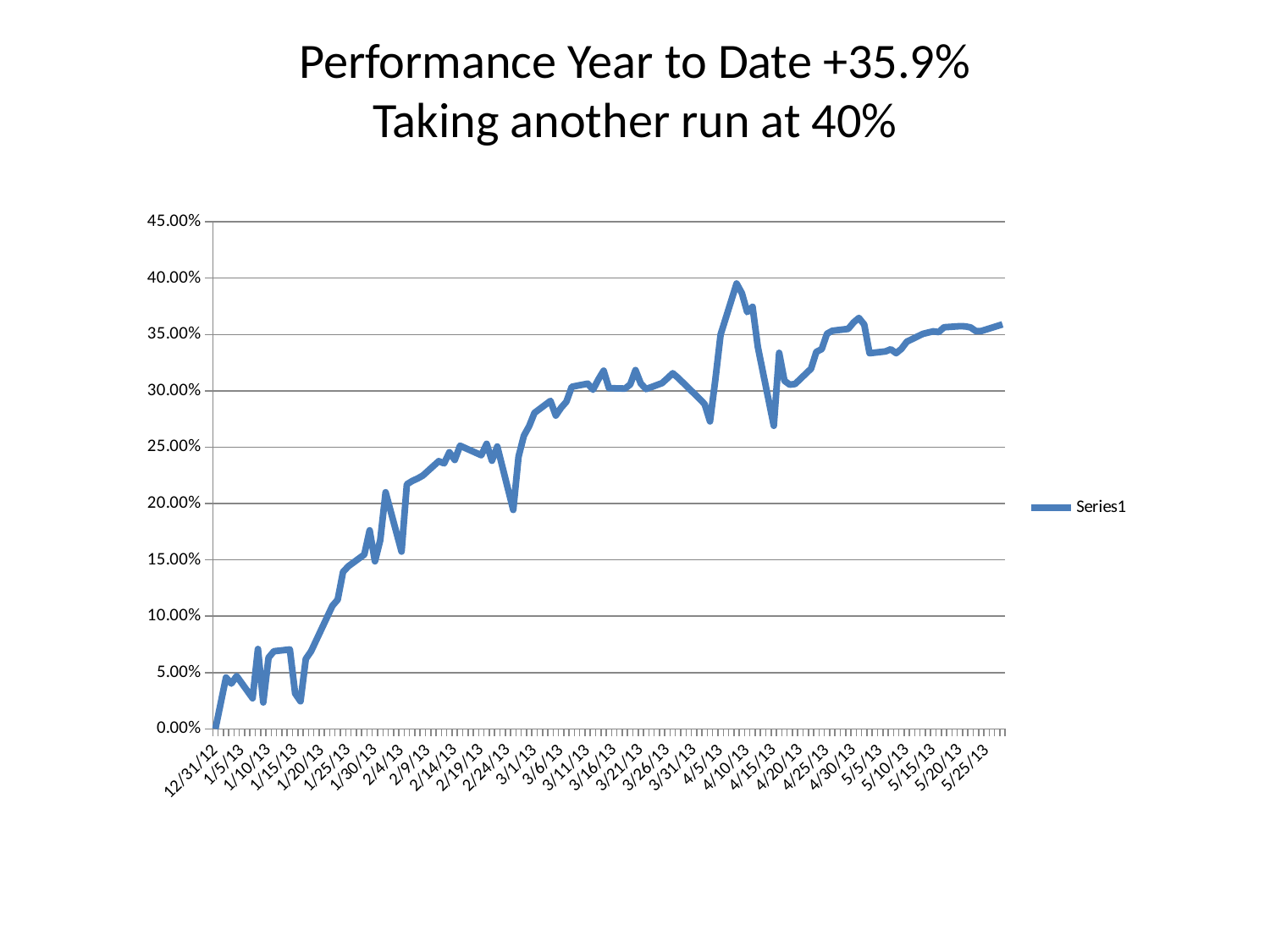
What is the name of the series shown in the legend? Series1 Overall, does the line rise or fall from 12/31/12 to 5/25/13? rise How many series does the legend list? 1 Is the highest point on the line greater or less than 35%? greater Which is larger, the value at 1/5/13 or the value at 5/25/13? 5/25/13 What year-to-date performance figure is stated in the chart title? +35.9% Is the value for 5/25/13 greater or less than 30%? greater What is the value of the line at 12/31/12, the first date on the x axis? 0.00% What is the highest tick value shown on the y axis? 45.00% Is the value for 3/11/13 greater or less than 25%? greater What kind of chart is shown on the slide? line chart